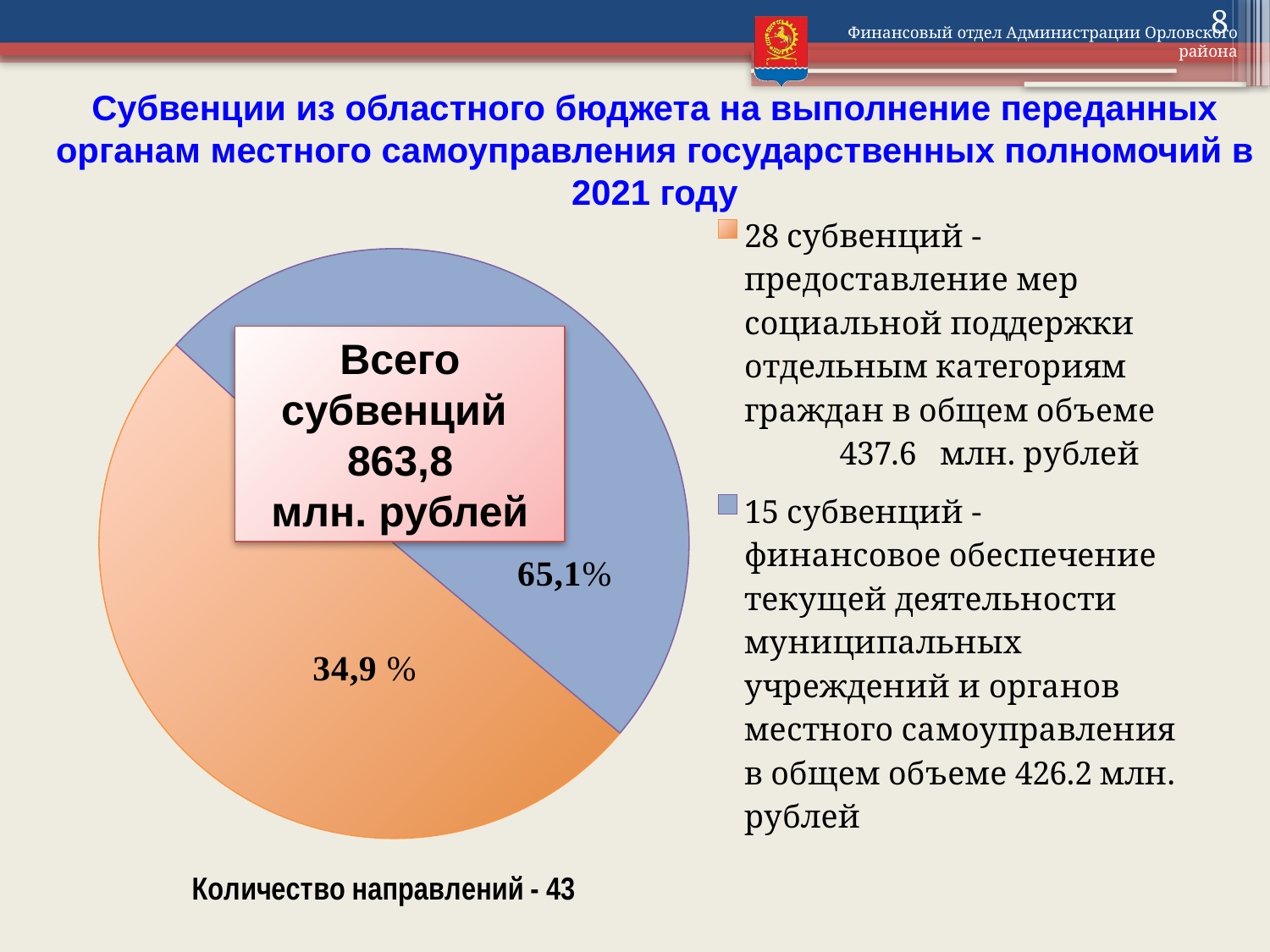
How many slices does the pie chart have? 2 Which group has the larger volume in the legend: the 28 subventions or the 15 subventions? 28 субвенций What colour is the legend marker for the 28 subventions group? orange According to the legend, what is the total volume of the 15 subventions for financing municipal institutions and local government bodies? 426.2 млн. рублей According to the legend, what is the total volume of the 28 subventions for social support measures? 437.6 млн. рублей How many entries does the legend next to the pie chart list? 2 What kind of chart is shown on the slide? pie chart What colour is the legend marker for the 15 subventions group? blue What is the number of directions (Количество направлений) stated under the pie chart? 43 Which two percentage values are printed on the pie chart? 65,1% and 34,9% Which colour slice of the pie chart is larger, the orange one or the blue one? orange What total amount of subventions is shown in the box over the pie chart? 863,8 млн. рублей